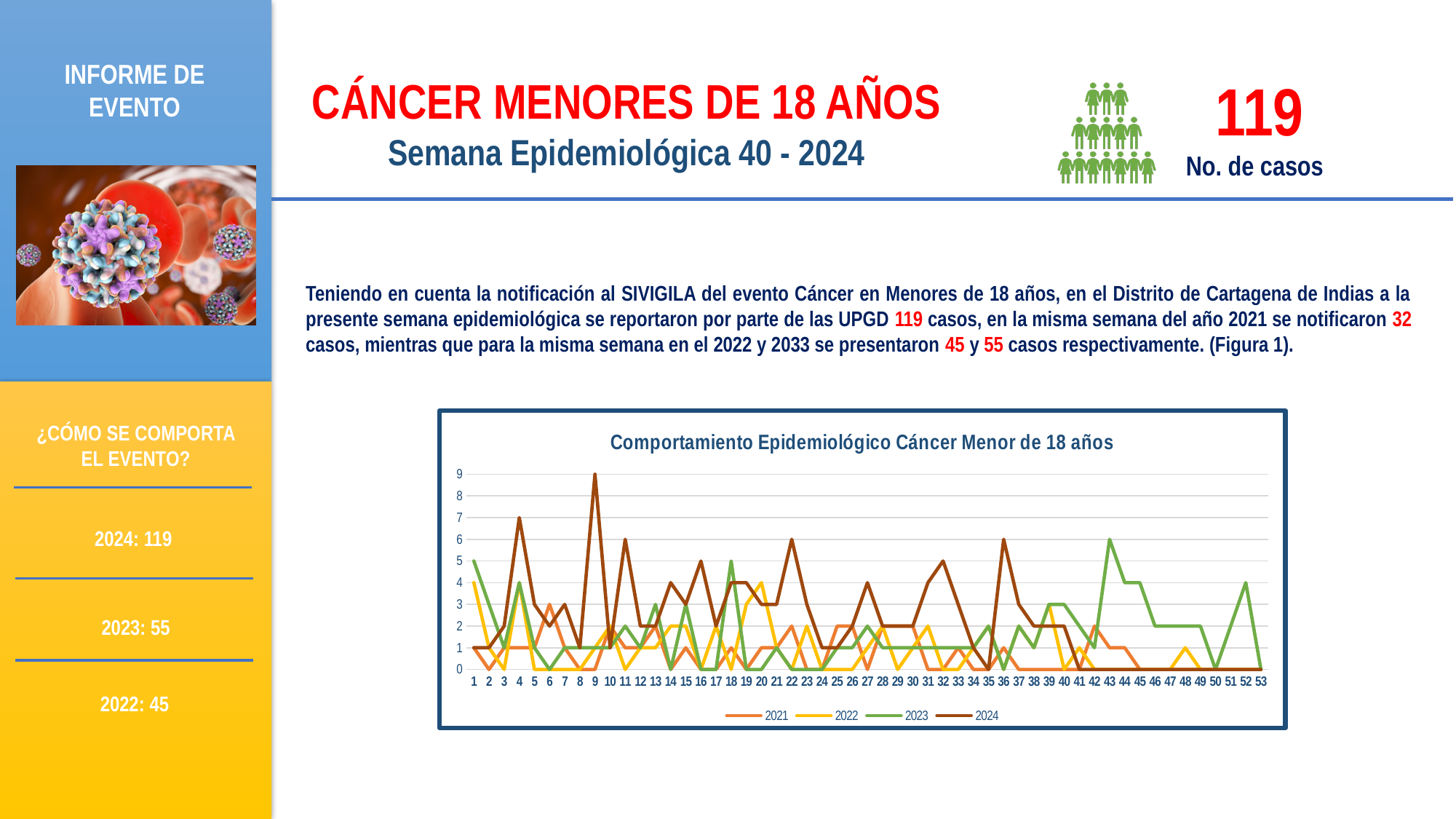
What is the value of the 2024 series in week 9? 9 How many weeks are shown along the x axis of the chart? 53 Is the value of the 2024 series in week 9 greater or less than 5? greater What colour is the line for the 2023 series? green What is the title of the chart? Comportamiento Epidemiológico Cáncer Menor de 18 años What is the value of the 2023 series in week 43? 6 In week 9, which series has the larger value, 2024 or 2023? 2024 How many series does the legend of the chart list? 4 What kind of chart is shown on the slide? line chart What is the value of the 2024 series in week 4? 7 Which series reaches the highest value on the chart? 2024 In which week does the 2024 series reach its highest value? 9